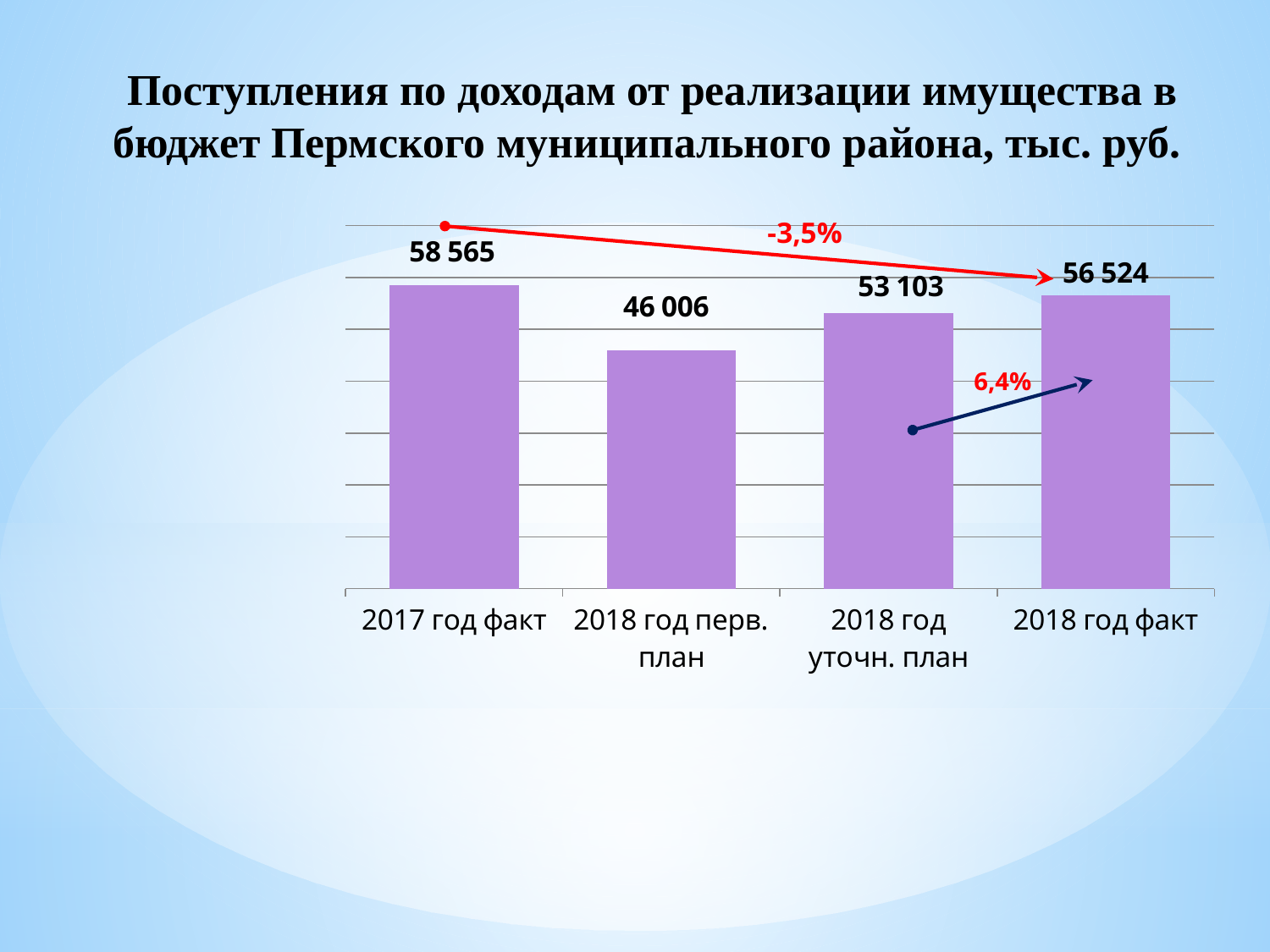
What kind of chart is shown on the slide? bar chart How many categories are shown on the x axis? 4 Which is larger, the value for 2018 год уточн. план or the value for 2018 год факт? 2018 год факт Which category has the lowest value? 2018 год перв. план What is the value for 2018 год уточн. план? 53 103 What is the value for 2018 год факт? 56 524 Which category has the highest value? 2017 год факт What is the difference between the values for 2017 год факт and 2018 год факт? 2 041 What percentage change is shown by the red arrow from 2017 год факт to 2018 год факт? -3,5% What is the difference between the values for 2018 год факт and 2018 год перв. план? 10 518 What is the value for 2017 год факт? 58 565 What is the value for 2018 год перв. план? 46 006